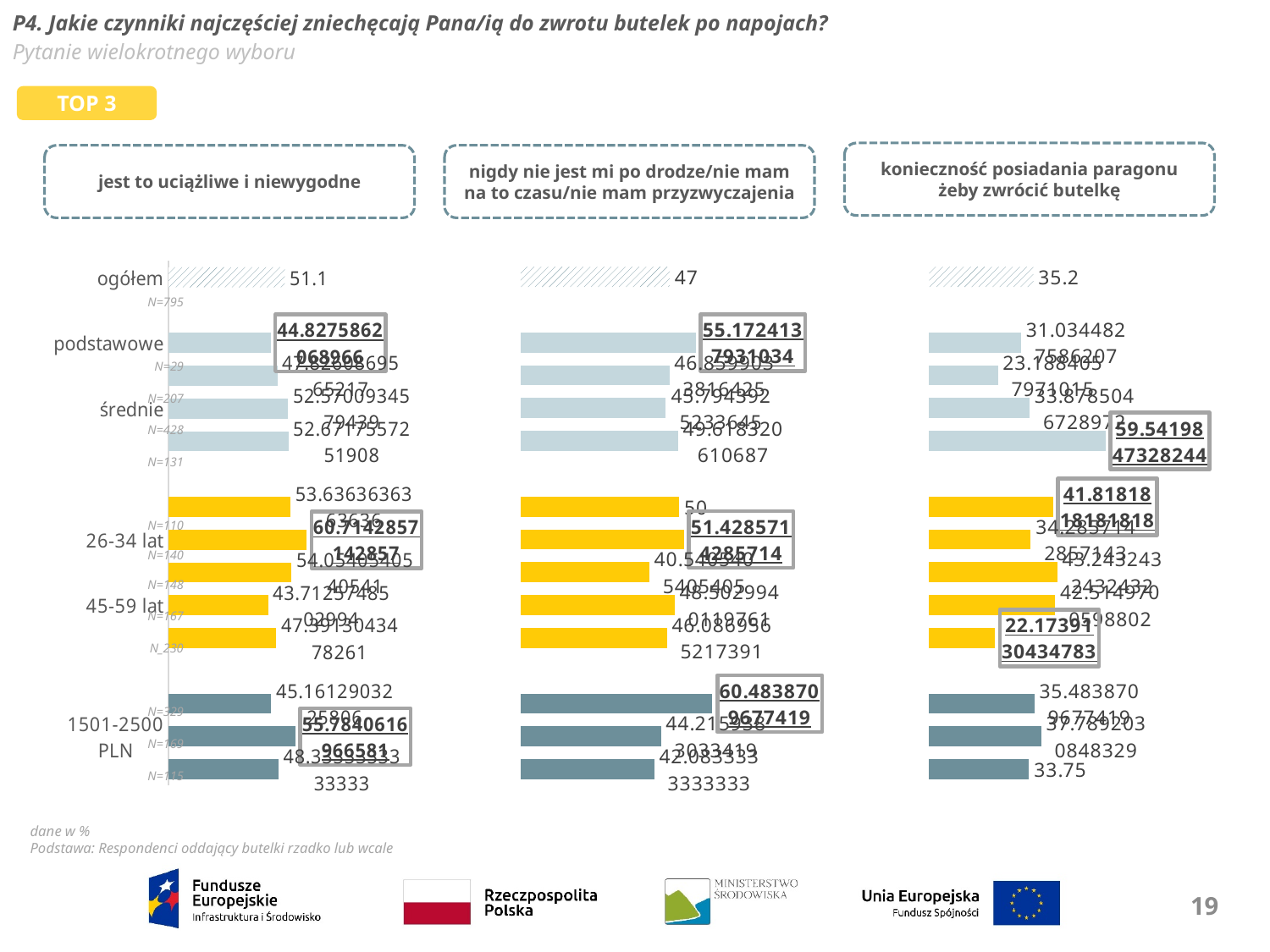
Across the three charts, which factor has the highest ogółem value? jest to uciążliwe i niewygodne In the chart titled 'nigdy nie jest mi po drodze/nie mam na to czasu/nie mam przyzwyczajenia', what is the value for ogółem? 47 In the chart titled 'konieczność posiadania paragonu żeby zwrócić butelkę', what is the value for ogółem? 35.2 What is the difference between the ogółem value in the 'jest to uciążliwe i niewygodne' chart and the ogółem value in the 'konieczność posiadania paragonu żeby zwrócić butelkę' chart? 15.9 How many charts are shown on the slide? 3 In the chart titled 'konieczność posiadania paragonu żeby zwrócić butelkę', is the ogółem value greater or less than 40? less In the chart titled 'jest to uciążliwe i niewygodne', what is the value for ogółem? 51.1 What kind of chart is used for the 'jest to uciążliwe i niewygodne' data? bar chart Across the three charts, which factor has the lowest ogółem value? konieczność posiadania paragonu żeby zwrócić butelkę According to the note at the bottom of the slide, in what unit are the chart values given? % What is the difference between the ogółem value in the 'jest to uciążliwe i niewygodne' chart and the ogółem value in the 'nigdy nie jest mi po drodze' chart? 4.1 Which is larger: the ogółem value in the 'jest to uciążliwe i niewygodne' chart or the ogółem value in the 'nigdy nie jest mi po drodze' chart? jest to uciążliwe i niewygodne